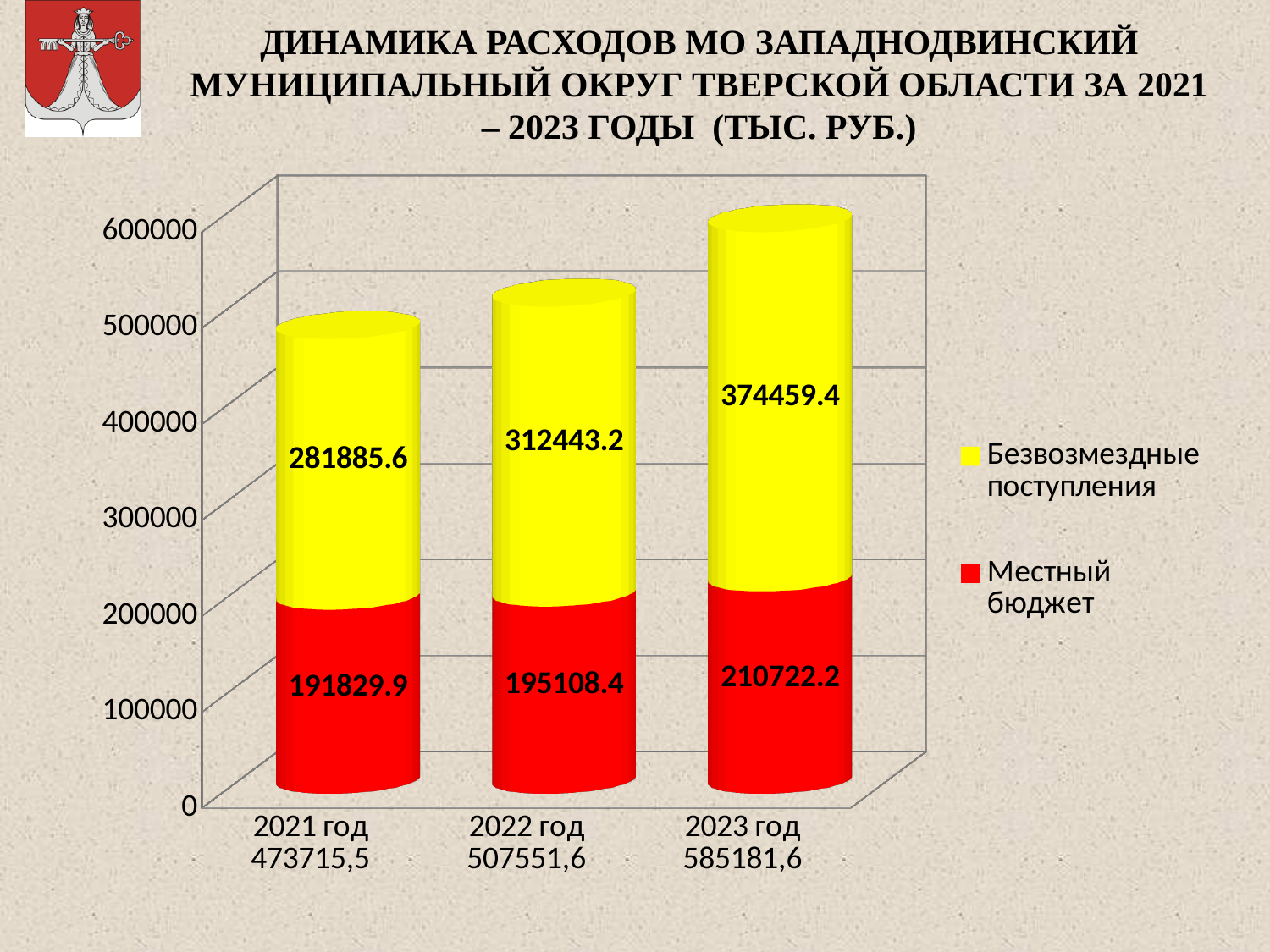
How many series does the legend list? 2 Which year has the lowest value for Местный бюджет? 2021 год What is the total of the stacked bar for 2022 год? 507551,6 Do the total expenditures rise or fall from 2021 год to 2023 год? Rise What is the difference between Безвозмездные поступления in 2023 год and in 2021 год? 92573.8 Which year has the highest value for Безвозмездные поступления? 2023 год Which is larger in 2022 год: Безвозмездные поступления or Местный бюджет? Безвозмездные поступления What is the value of Местный бюджет for 2022 год? 195108.4 How many years are shown on the x axis? 3 What is the value of Безвозмездные поступления for 2021 год? 281885.6 What kind of chart is shown on the slide? Stacked bar chart What is the value of Местный бюджет for 2023 год? 210722.2